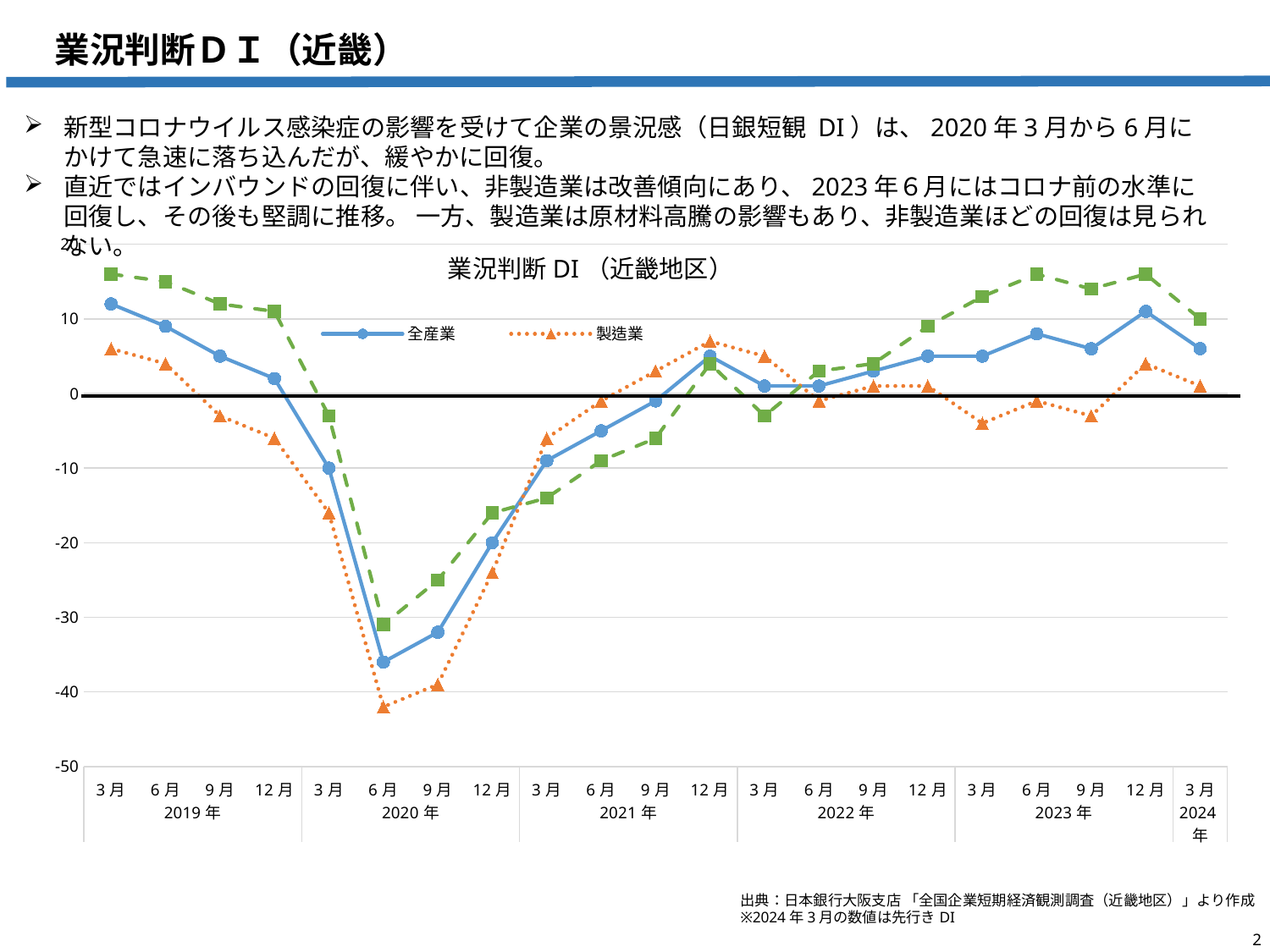
What kind of chart is shown on the slide? line chart Is the value for 製造業 in 2019年12月 greater or less than 0? less Is the value for 全産業 in 2020年6月 greater or less than -30? less Does the 全産業 series rise or fall from 2019年3月 to 2020年6月? fall Is the value for 全産業 in 2019年3月 greater or less than 10? greater What is the title of the chart? 業況判断DI（近畿地区） Which two series are named in the chart's legend? 全産業 and 製造業 How many time points are plotted along the x axis of the chart? 21 In 2020年6月, which series has the higher value, 全産業 or 製造業? 全産業 How many series does the chart's legend list? 2 At which time point does the 全産業 series reach its lowest value? 2020年6月